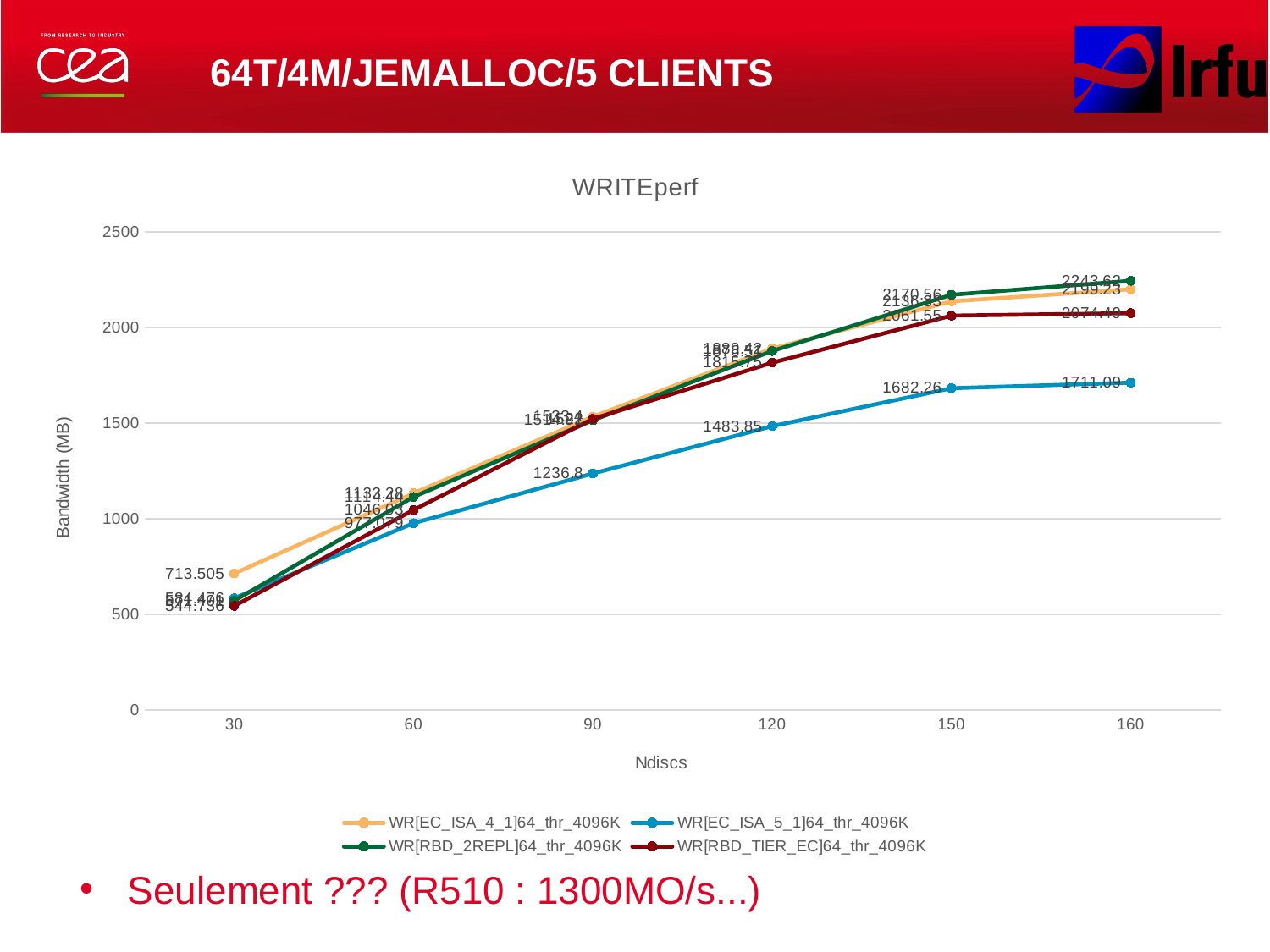
What is the difference between the WR[EC_ISA_5_1]64_thr_4096K values at 160 and 150 Ndiscs? 28.83 How many series does the legend list? 4 What type of chart is shown on the slide? line chart What is the value of WR[RBD_2REPL]64_thr_4096K at 160 Ndiscs? 2243.62 How many Ndiscs values are plotted along the x axis? 6 Which series has the highest value at 160 Ndiscs? WR[RBD_2REPL]64_thr_4096K Do the bandwidth values rise or fall as Ndiscs increases? rise What is the value of WR[EC_ISA_5_1]64_thr_4096K at 160 Ndiscs? 1711.09 What is the title of the chart? WRITEperf What is the value of WR[EC_ISA_4_1]64_thr_4096K at 30 Ndiscs? 713.505 Which series has the lowest value at 120 Ndiscs? WR[EC_ISA_5_1]64_thr_4096K What is the value of WR[EC_ISA_5_1]64_thr_4096K at 90 Ndiscs? 1236.8